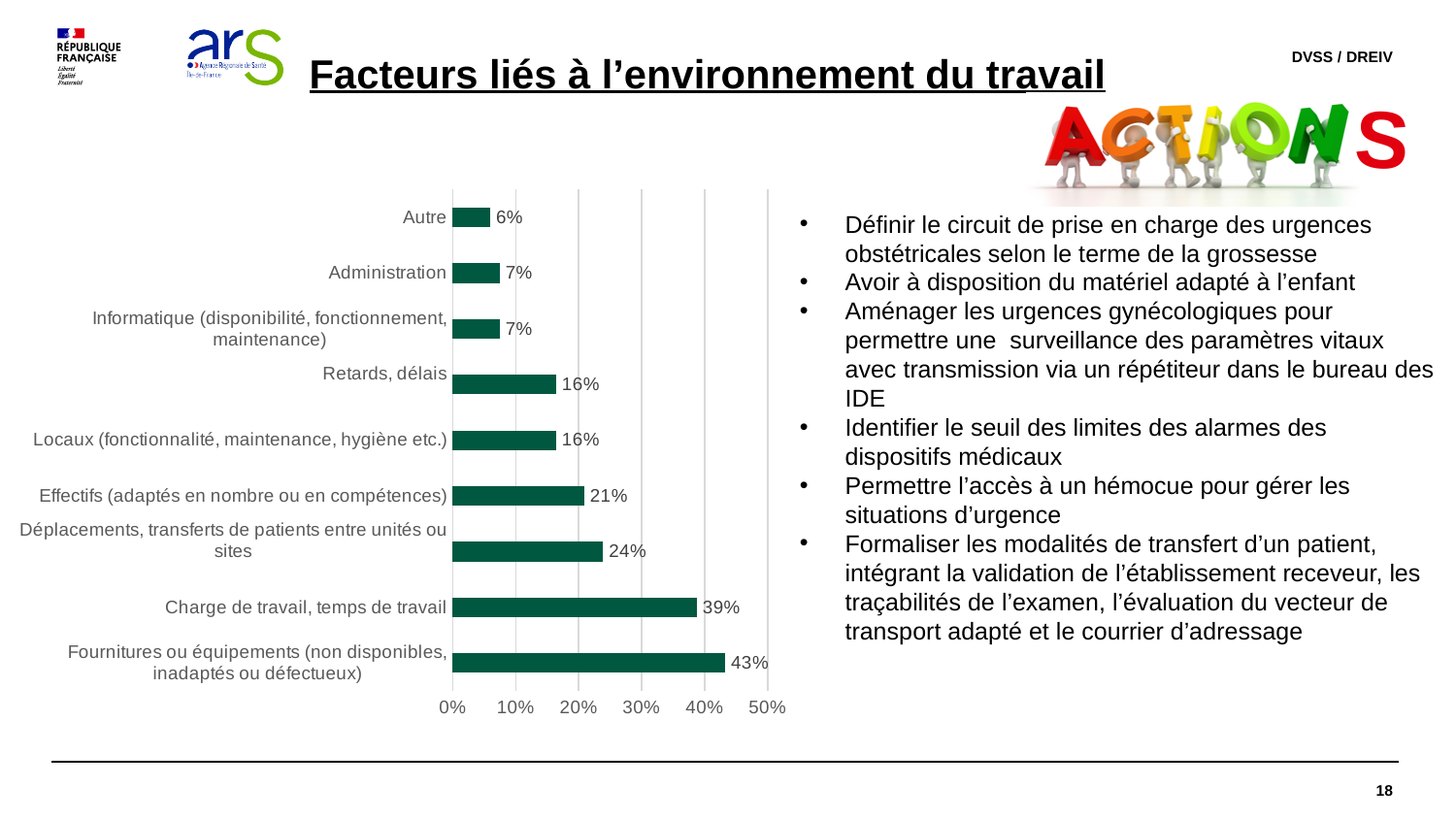
What is the value for "Charge de travail, temps de travail"? 39% What is the difference between the values for "Fournitures ou équipements (non disponibles, inadaptés ou défectueux)" and "Charge de travail, temps de travail"? 4% What is the value for "Autre"? 6% What is the value for "Effectifs (adaptés en nombre ou en compétences)"? 21% Which is larger: the value for "Déplacements, transferts de patients entre unités ou sites" or the value for "Effectifs (adaptés en nombre ou en compétences)"? Déplacements, transferts de patients entre unités ou sites What is the maximum value shown on the horizontal axis of the chart? 50% How many categories are shown in the chart? 9 Which category has the lowest value? Autre Which category has the highest value? Fournitures ou équipements (non disponibles, inadaptés ou défectueux) What is the value for "Administration"? 7% What kind of chart is shown on the slide? bar chart Is the value for "Retards, délais" greater or less than 20%? less